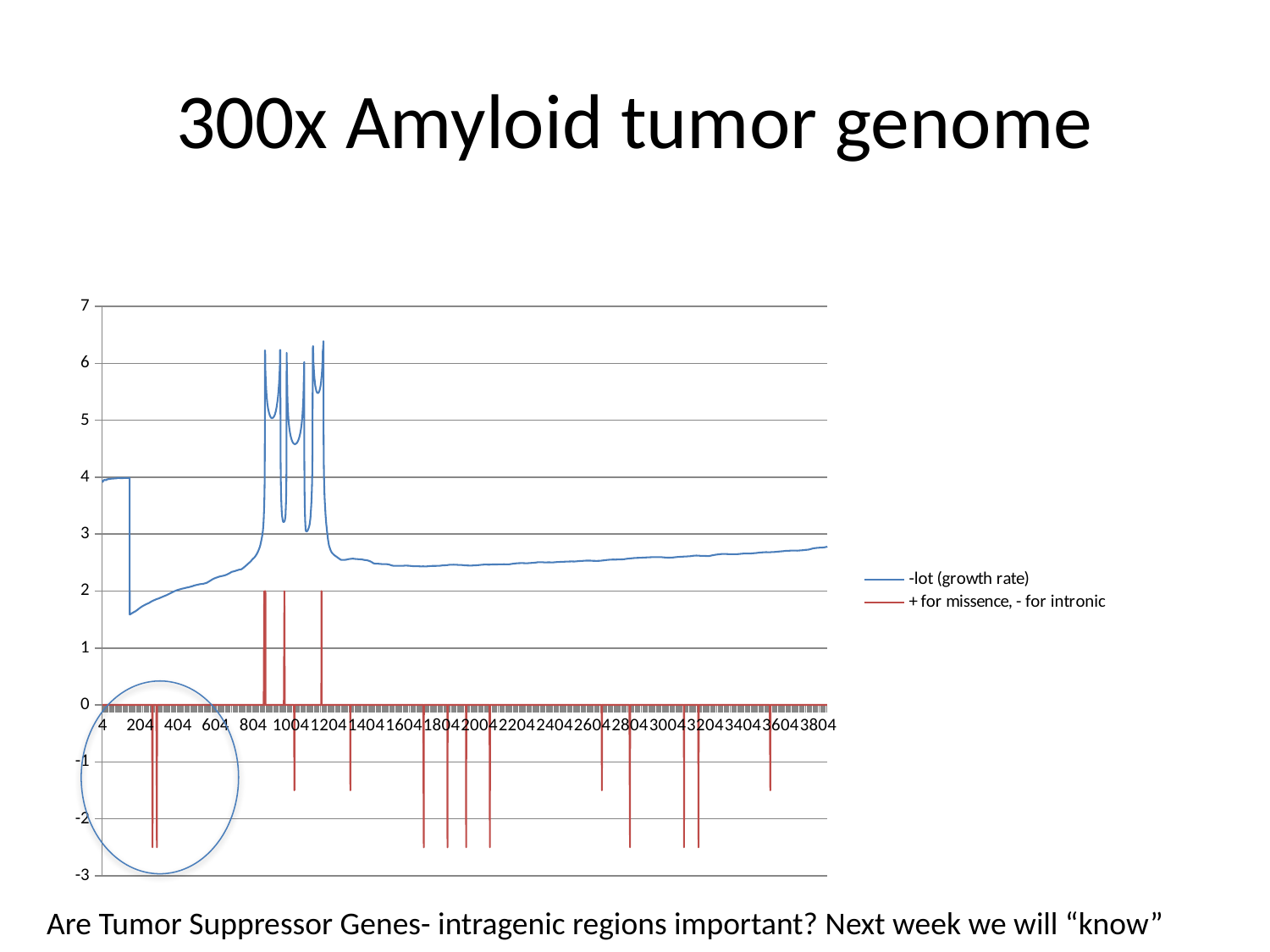
Is the value of the -lot (growth rate) series at x = 4 greater or less than 3? greater Is the lowest value of the -lot (growth rate) series greater or less than 2? less Which series is drawn in red according to the legend? + for missence, - for intronic Is the -lot (growth rate) value larger at x = 4 or at x = 3804? x = 4 What kind of chart is shown on the slide? line chart Does the -lot (growth rate) series rise or fall between x = 1404 and x = 3804? rise Are the positive spikes of the + for missence, - for intronic series between x = 804 and x = 1204 greater or less than 1? greater How many series does the legend list? 2 What is the lowest value shown on the y axis? -3 What is the title of the chart on the slide? 300x Amyloid tumor genome